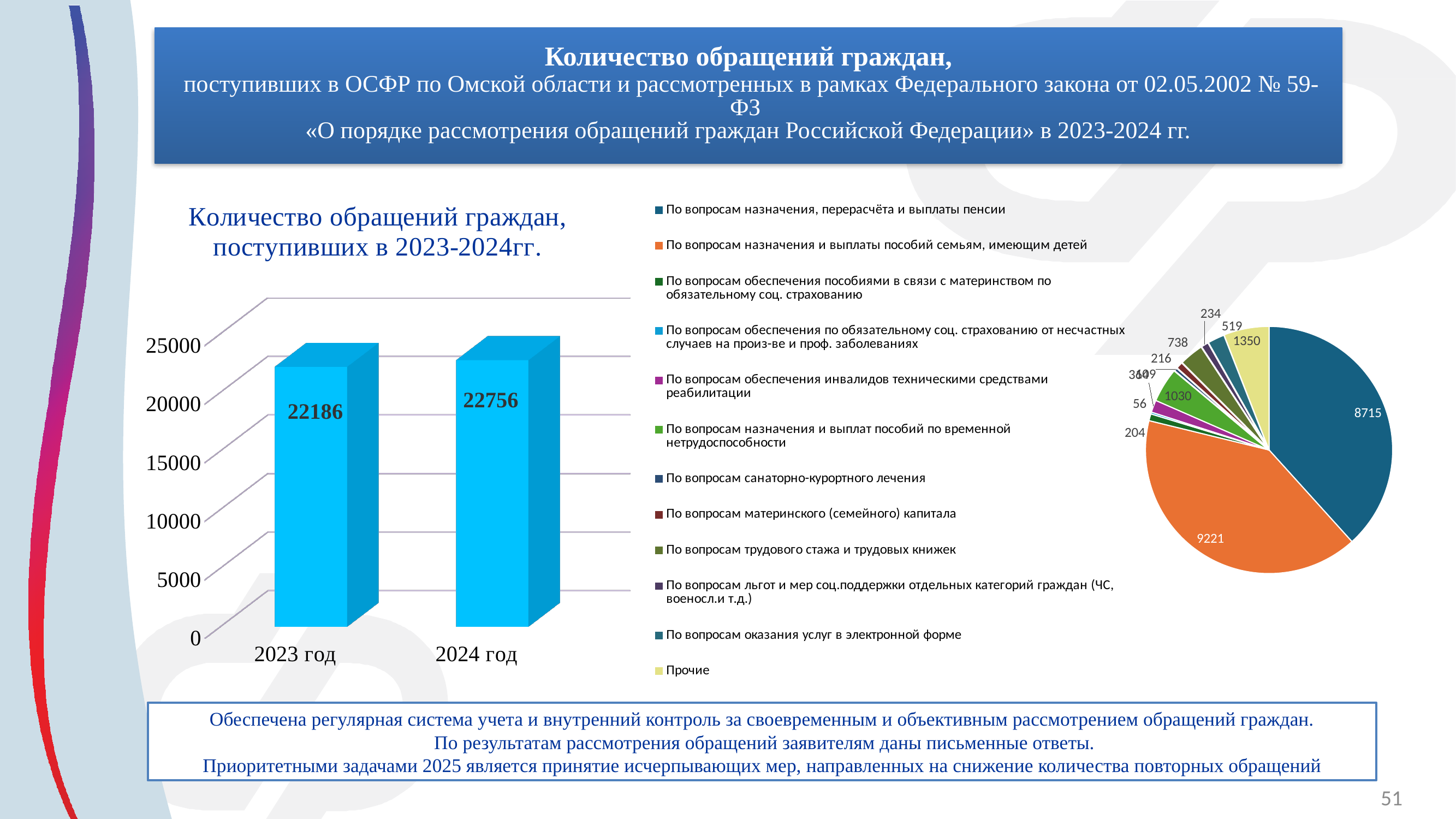
What kind of chart is the chart on the left of the slide? bar chart In the pie chart on the right, what is the value for Прочие? 1350 What kind of chart is the chart on the right of the slide? pie chart In the bar chart on the left, which year has the higher value, 2023 год or 2024 год? 2024 год In the pie chart on the right, what is the value for По вопросам назначения, перерасчёта и выплаты пенсии? 8715 In the bar chart on the left, do the values rise or fall from 2023 год to 2024 год? rise In the bar chart on the left, what is the difference between the values for 2024 год and 2023 год? 570 In the bar chart on the left, how many categories are shown on the x axis? 2 In the bar chart on the left, what is the value for 2023 год? 22186 In the bar chart on the left, what is the value for 2024 год? 22756 In the pie chart on the right, which category has the largest slice? По вопросам назначения и выплаты пособий семьям, имеющим детей In the pie chart on the right, how many categories does the legend list? 12